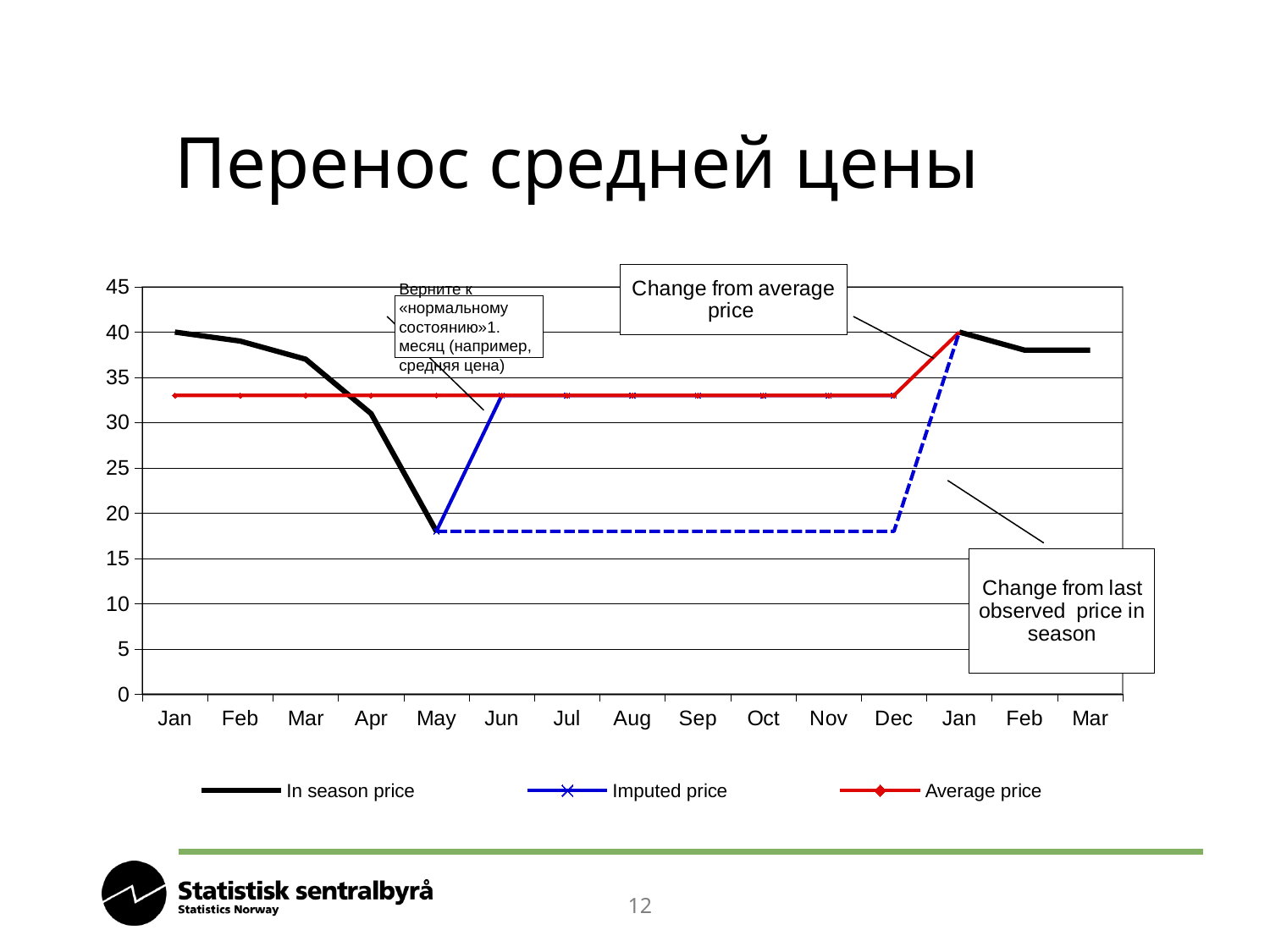
Does the In season price rise or fall from the first Jan to May? fall What kind of chart is shown on the slide? line chart Is the In season price in Apr greater or less than 35? less Is the In season price in the second Feb greater or less than 35? greater Is the Imputed price in Sep greater or less than 20? greater What colour is the Average price line? red What is the title of the slide? Перенос средней цены How many series does the legend list? 3 How many points are there along the x axis? 15 What is the In season price in the first Jan? 40